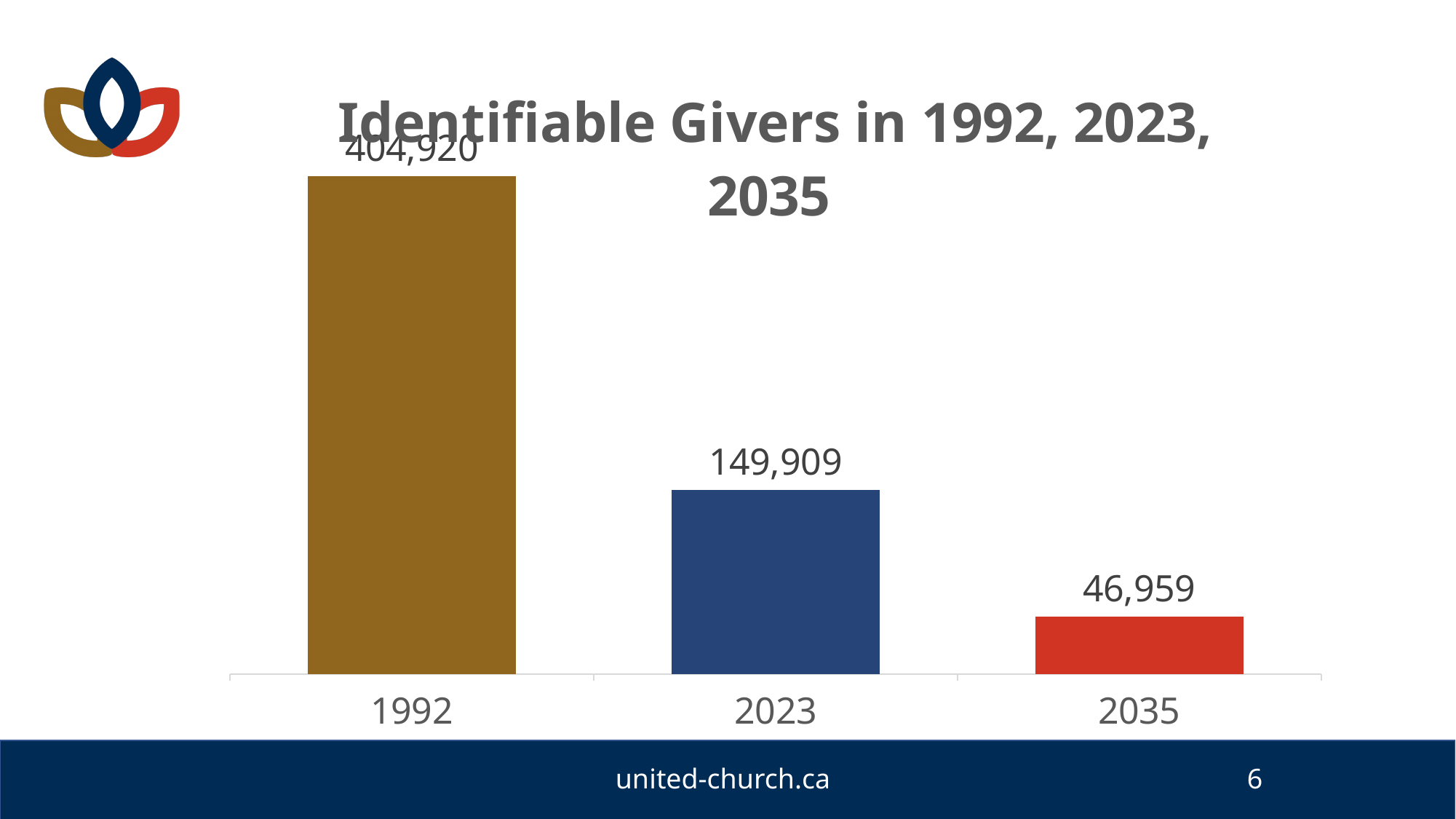
What is the difference between the values for 2023 and 2035? 102,950 What kind of chart is shown on the slide? bar chart How many years are shown on the chart? 3 What is the title of the chart? Identifiable Givers in 1992, 2023, 2035 What is the value for 1992? 404,920 What is the value for 2023? 149,909 Which year has the highest number of identifiable givers? 1992 Which is larger, the value for 2023 or the value for 2035? 2023 Do the values rise or fall from 1992 to 2035? fall What is the value for 2035? 46,959 Which year has the lowest number of identifiable givers? 2035 What is the difference between the values for 1992 and 2023? 255,011